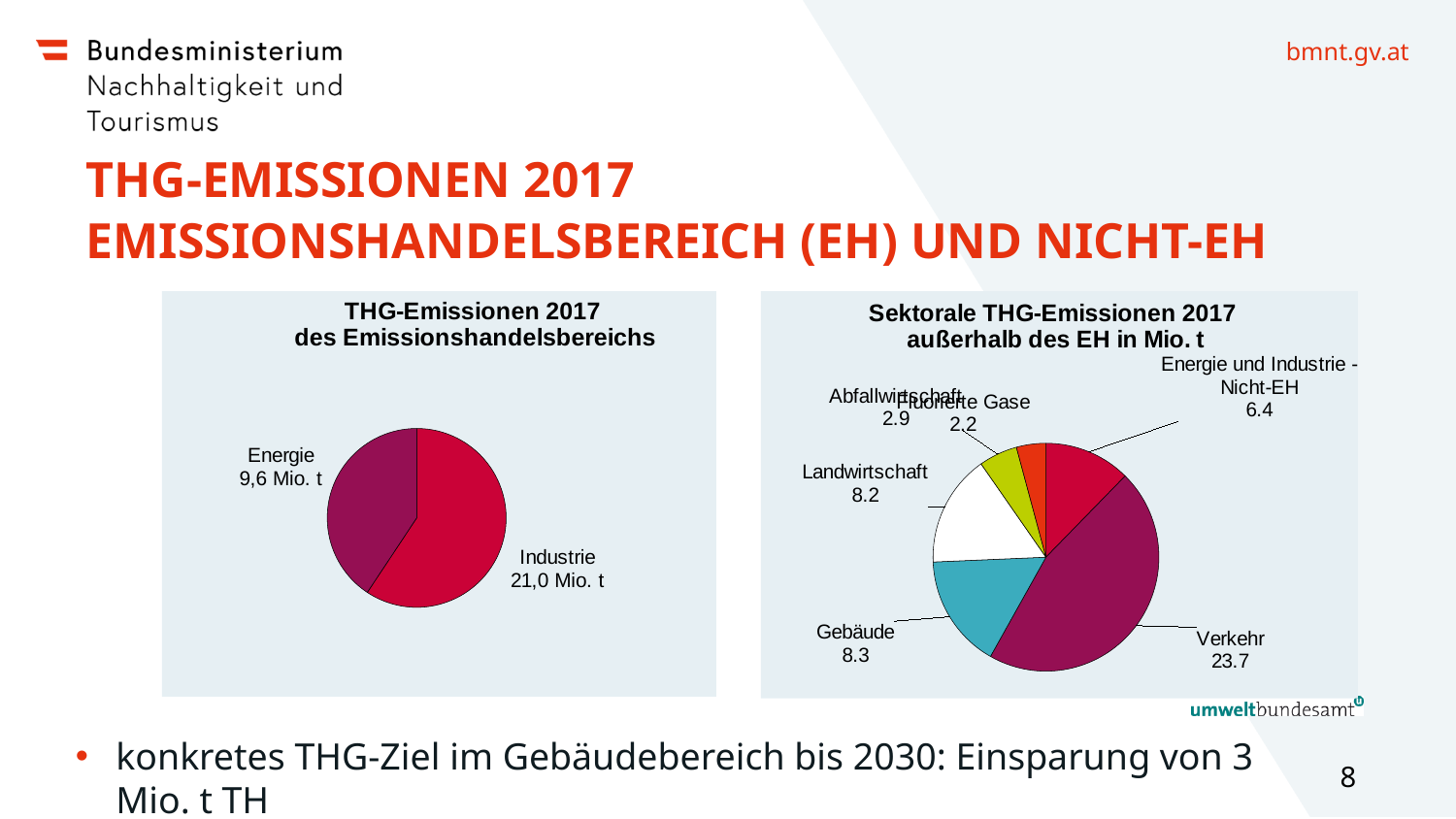
In the right chart 'Sektorale THG-Emissionen 2017 außerhalb des EH in Mio. t', what is the value for Landwirtschaft? 8.2 In the left chart 'THG-Emissionen 2017 des Emissionshandelsbereichs', what is the difference between Industrie and Energie? 11,4 Mio. t In the left chart 'THG-Emissionen 2017 des Emissionshandelsbereichs', what is the value for Industrie? 21,0 Mio. t In the left chart 'THG-Emissionen 2017 des Emissionshandelsbereichs', which slice is larger, Energie or Industrie? Industrie In the right chart 'Sektorale THG-Emissionen 2017 außerhalb des EH in Mio. t', which sector has the lowest emissions? Fluorierte Gase In the right chart 'Sektorale THG-Emissionen 2017 außerhalb des EH in Mio. t', which sector has the highest emissions? Verkehr How many sectors are shown in the right chart 'Sektorale THG-Emissionen 2017 außerhalb des EH in Mio. t'? 6 What kind of chart is the left chart, 'THG-Emissionen 2017 des Emissionshandelsbereichs'? Pie chart How many slices does the left chart 'THG-Emissionen 2017 des Emissionshandelsbereichs' have? 2 In the right chart 'Sektorale THG-Emissionen 2017 außerhalb des EH in Mio. t', what is the value for Verkehr? 23.7 In the right chart 'Sektorale THG-Emissionen 2017 außerhalb des EH in Mio. t', what is the difference between Verkehr and Gebäude? 15.4 In the left chart 'THG-Emissionen 2017 des Emissionshandelsbereichs', what is the value for Energie? 9,6 Mio. t